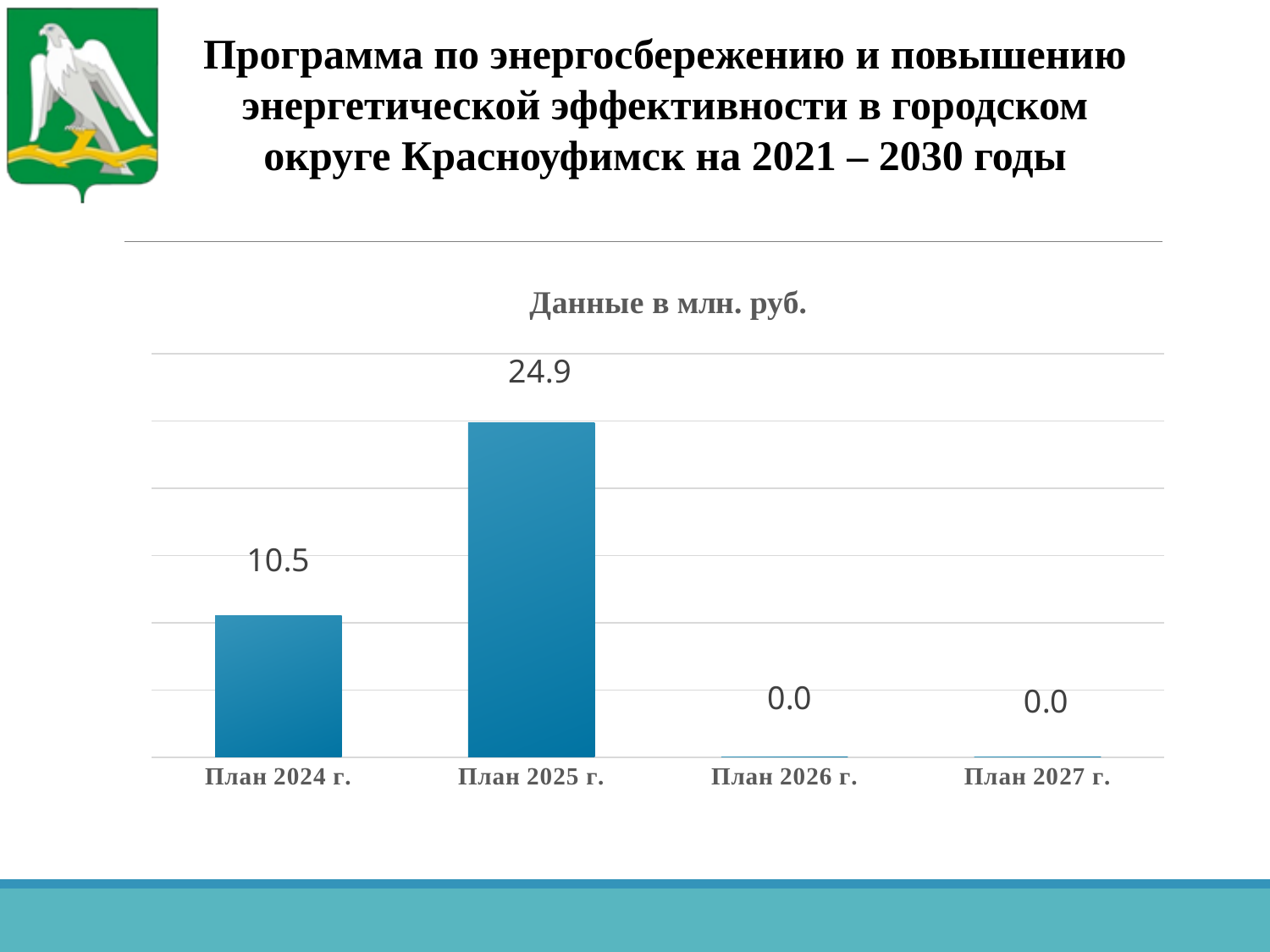
What colour are the bars in the chart? blue What is the value for План 2026 г.? 0.0 What kind of chart is shown on the slide? bar chart What is the title of the chart? Данные в млн. руб. What is the total of the values for all four categories? 35.4 What is the value for План 2027 г.? 0.0 Which category has the highest value? План 2025 г. How many categories are shown on the x axis? 4 What is the value for План 2024 г.? 10.5 What is the difference between the values for План 2025 г. and План 2024 г.? 14.4 Which is larger, the value for План 2024 г. or the value for План 2025 г.? План 2025 г. What is the value for План 2025 г.? 24.9